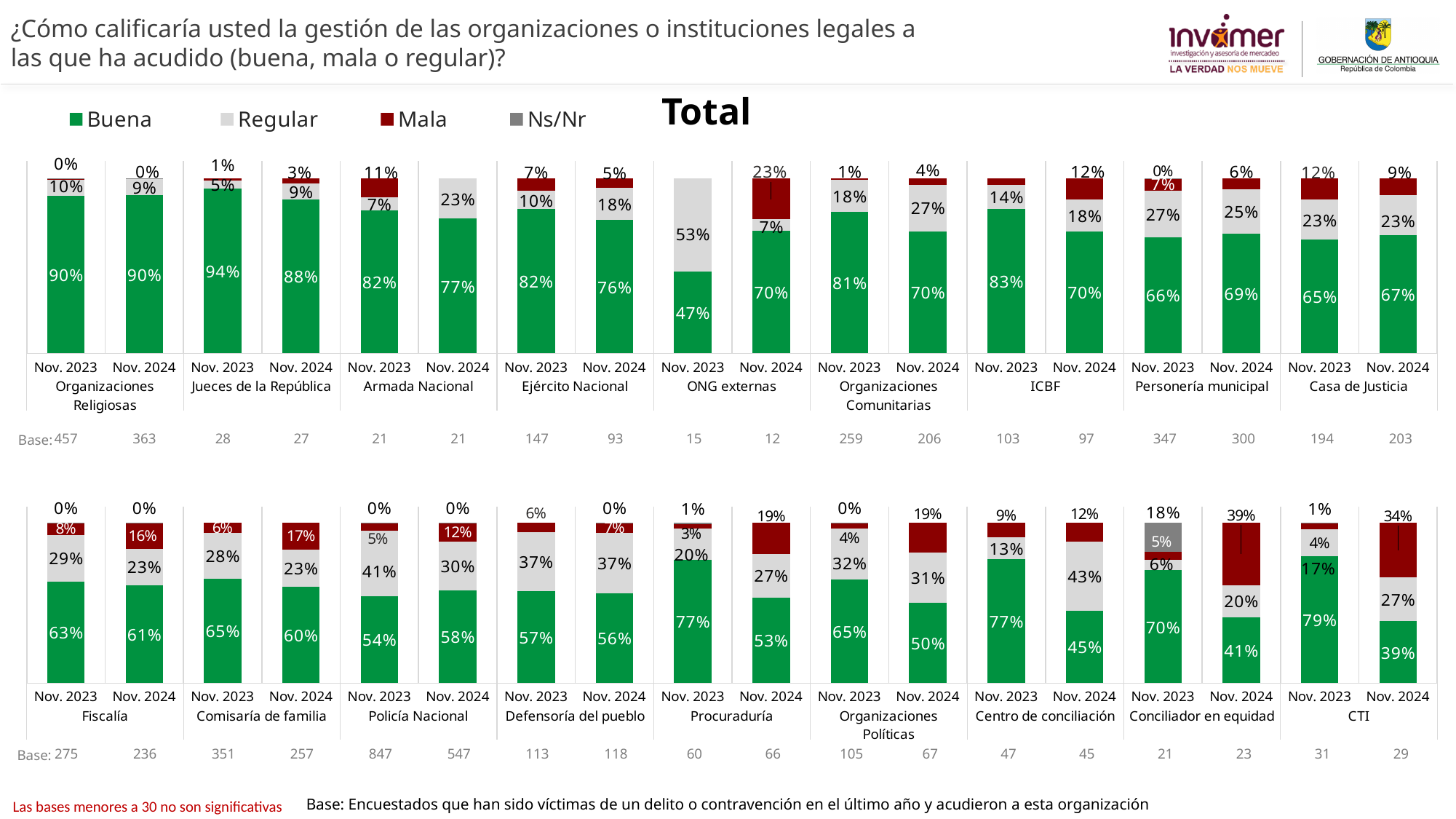
How many institutions are shown in the top chart? 9 How many series does the legend list? 4 In the top chart, what is the Regular percentage for ONG externas in Nov. 2023? 53% What type of chart is used on this slide? Stacked bar chart In the top chart, which institution has the highest Buena percentage across all bars? Jueces de la República (Nov. 2023) Which colour represents the Mala category in the legend? Dark red In the top chart, what percentage of respondents rated Organizaciones Religiosas as Buena in Nov. 2023? 90% In the bottom chart, what is the Mala percentage for CTI in Nov. 2024? 34% In the top chart, which is larger for Casa de Justicia: the Buena percentage in Nov. 2023 or in Nov. 2024? Nov. 2024 In the bottom chart, which bar has the lowest Buena percentage? CTI Nov. 2024 In the bottom chart, by how many percentage points did the Buena rating for Centro de conciliación fall from Nov. 2023 to Nov. 2024? 32 percentage points In the bottom chart, what is the Regular percentage for Policía Nacional in Nov. 2023? 41%